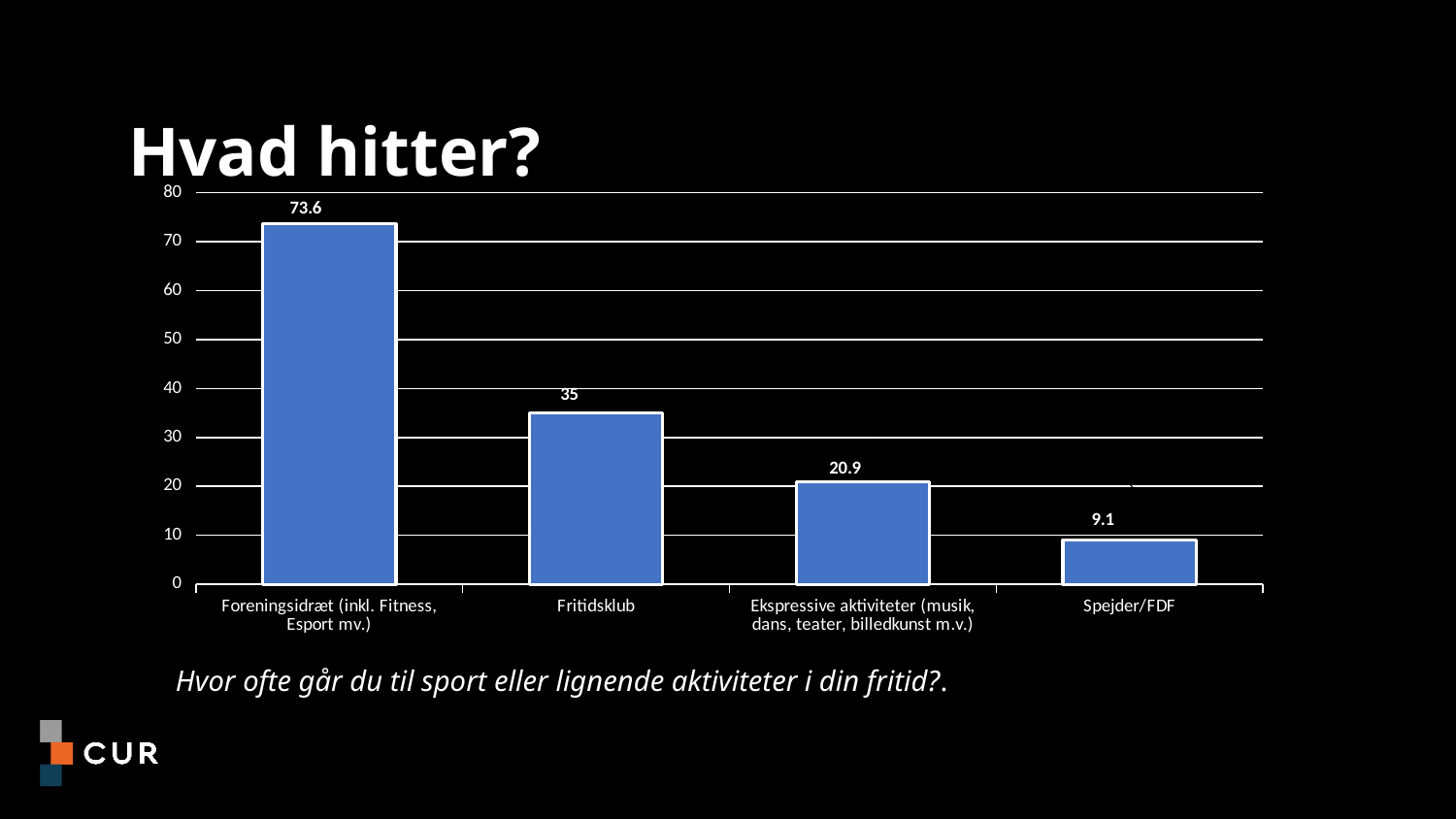
What is the difference between the values for Foreningsidræt (inkl. Fitness, Esport mv.) and Fritidsklub? 38.6 Which category has the highest value? Foreningsidræt (inkl. Fitness, Esport mv.) What is the value for Spejder/FDF? 9.1 Which is larger, the value for Fritidsklub or the value for Ekspressive aktiviteter? Fritidsklub What is the value for Fritidsklub? 35 How many categories are shown in the chart? 4 What is the value for Ekspressive aktiviteter (musik, dans, teater, billedkunst m.v.)? 20.9 What kind of chart is shown on the slide? bar chart Which category has the lowest value? Spejder/FDF What is the difference between the values for Ekspressive aktiviteter and Spejder/FDF? 11.8 What is the value for Foreningsidræt (inkl. Fitness, Esport mv.)? 73.6 Do the values rise or fall from left to right along the x axis? fall